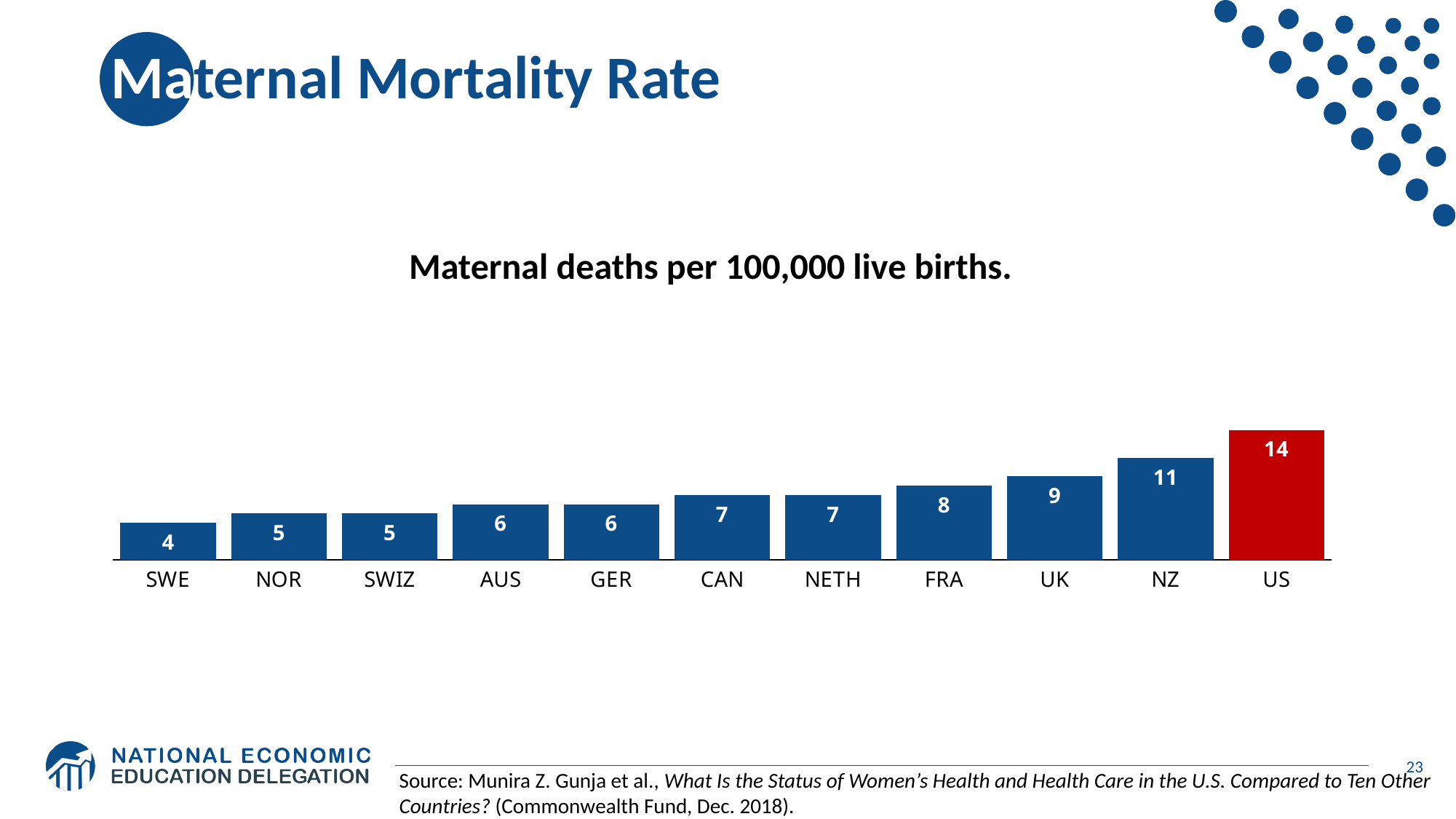
What is the difference between the values for the UK and SWE? 5 Which country has the lowest maternal mortality rate? SWE What is the difference between the values for the US and NZ? 3 How many countries are shown in the chart? 11 What is the maternal mortality rate for the US? 14 Which has a higher value, UK or FRA? UK Which bar is coloured red rather than blue? US What is the value shown for SWE? 4 What is the value shown for FRA? 8 What kind of chart is shown on the slide? Bar chart What is the value shown for NZ? 11 Which country has the highest maternal mortality rate? US